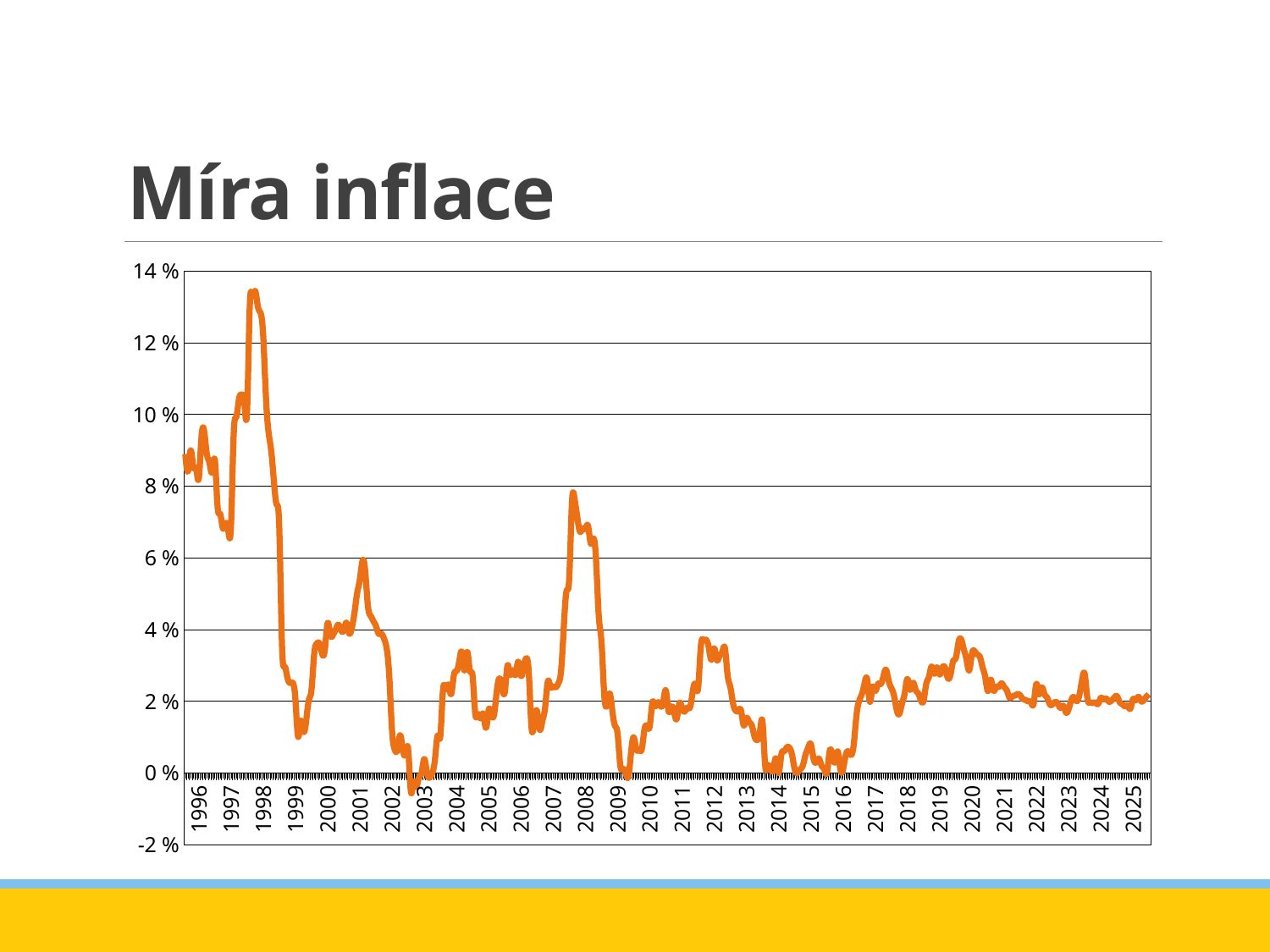
Is the value for 2024 greater or less than 4 %? less Is the value for 2015 greater or less than 2 %? less What is the highest value shown on the vertical axis? 14 % How many year labels are shown on the horizontal axis? 30 Does the inflation rate rise or fall from 2007 to early 2008? rise What is the title of the chart? Míra inflace Is the peak value in 1998 greater or less than 12 %? greater Does the inflation rate rise or fall from 1998 to 1999? fall What kind of chart is shown on the slide? line chart In which year does the inflation rate reach its highest peak? 1998